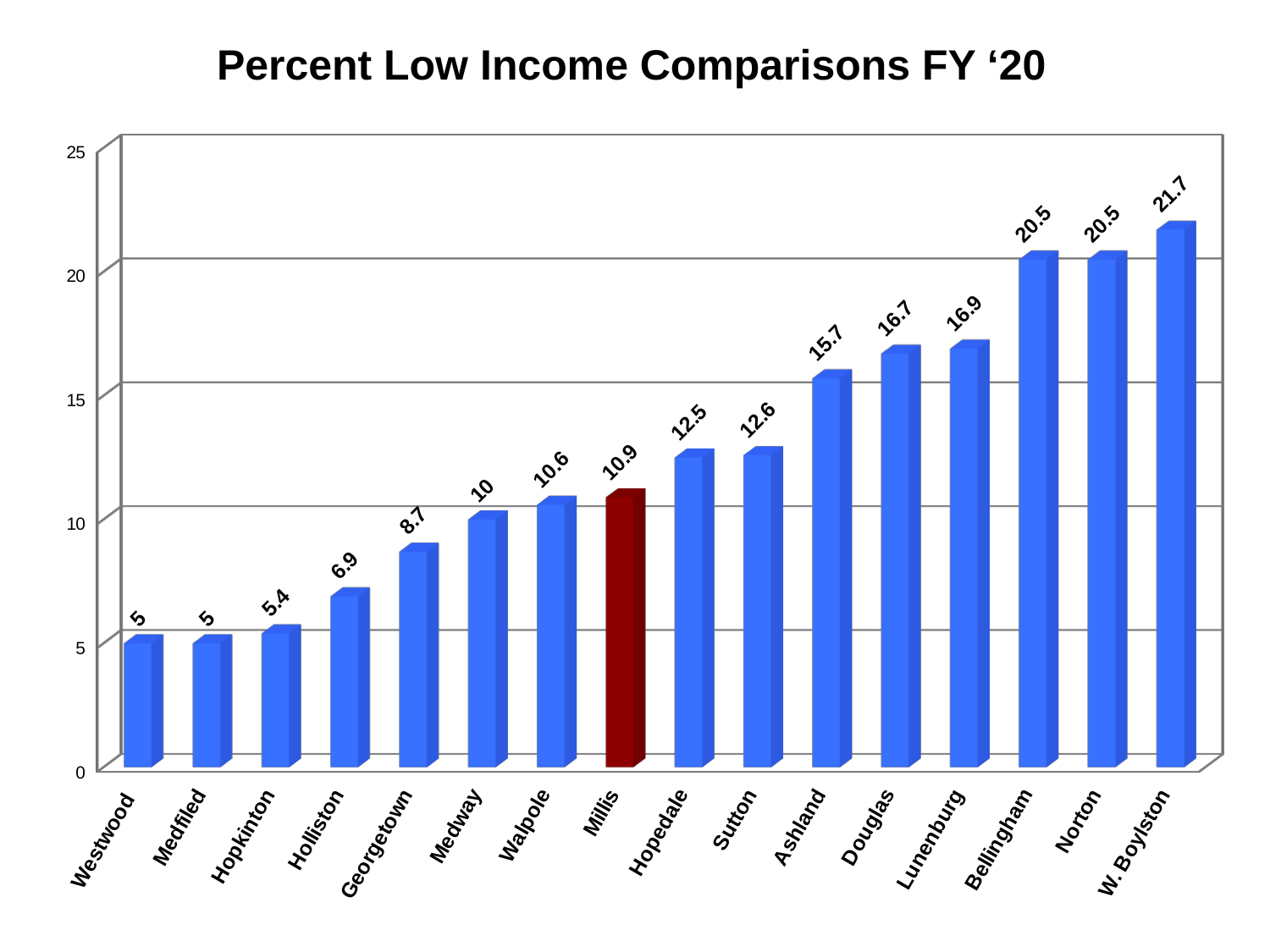
What is the value for Georgetown? 8.7 What is the difference between the values for Ashland and Millis? 4.8 How many towns are shown on the chart? 16 Which is larger, the value for Hopedale or the value for Walpole? Hopedale What is the value for Lunenburg? 16.9 What kind of chart is shown? bar chart Is the value for Douglas greater or less than 15? greater What is the value for Millis? 10.9 Which town has the highest value? W. Boylston What is the difference between the values for W. Boylston and Westwood? 16.7 Which town's bar is coloured dark red instead of blue? Millis Do the values rise or fall from left to right along the x axis? rise